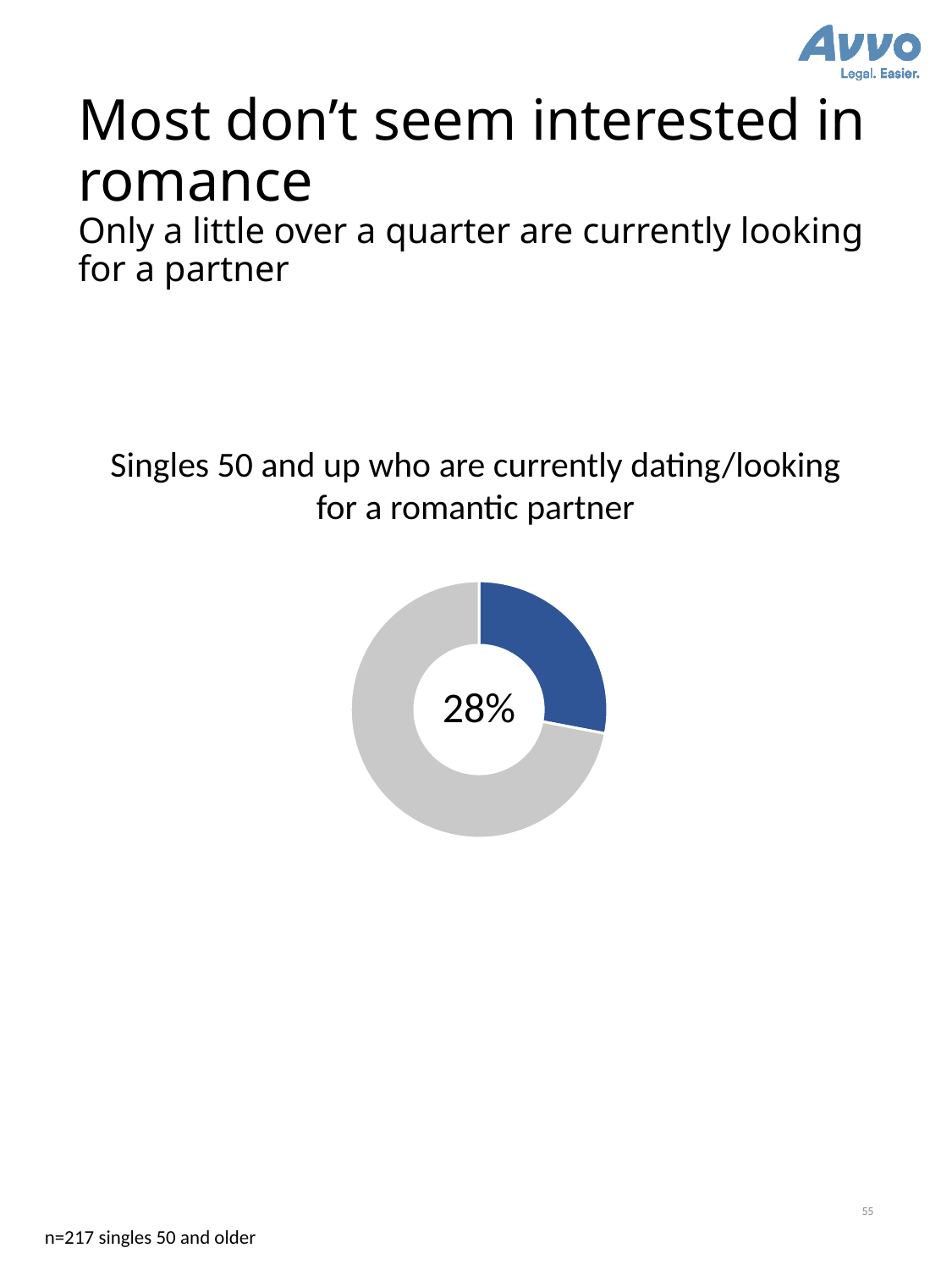
What colour is the slice representing the 28% of singles 50 and up who are currently dating/looking for a partner? Blue What kind of chart is shown on the slide? Donut chart What percentage of singles 50 and up are currently dating/looking for a romantic partner, according to the chart? 28% What value is printed in the centre of the donut chart? 28% How many slices does the donut chart have? 2 What is the title of the chart? Singles 50 and up who are currently dating/looking for a romantic partner What share of the donut chart does the blue slice represent? 28% Is the share of singles 50 and up currently dating/looking for a partner greater or less than 50%? less Which slice of the donut chart is larger, the blue slice or the grey slice? Grey